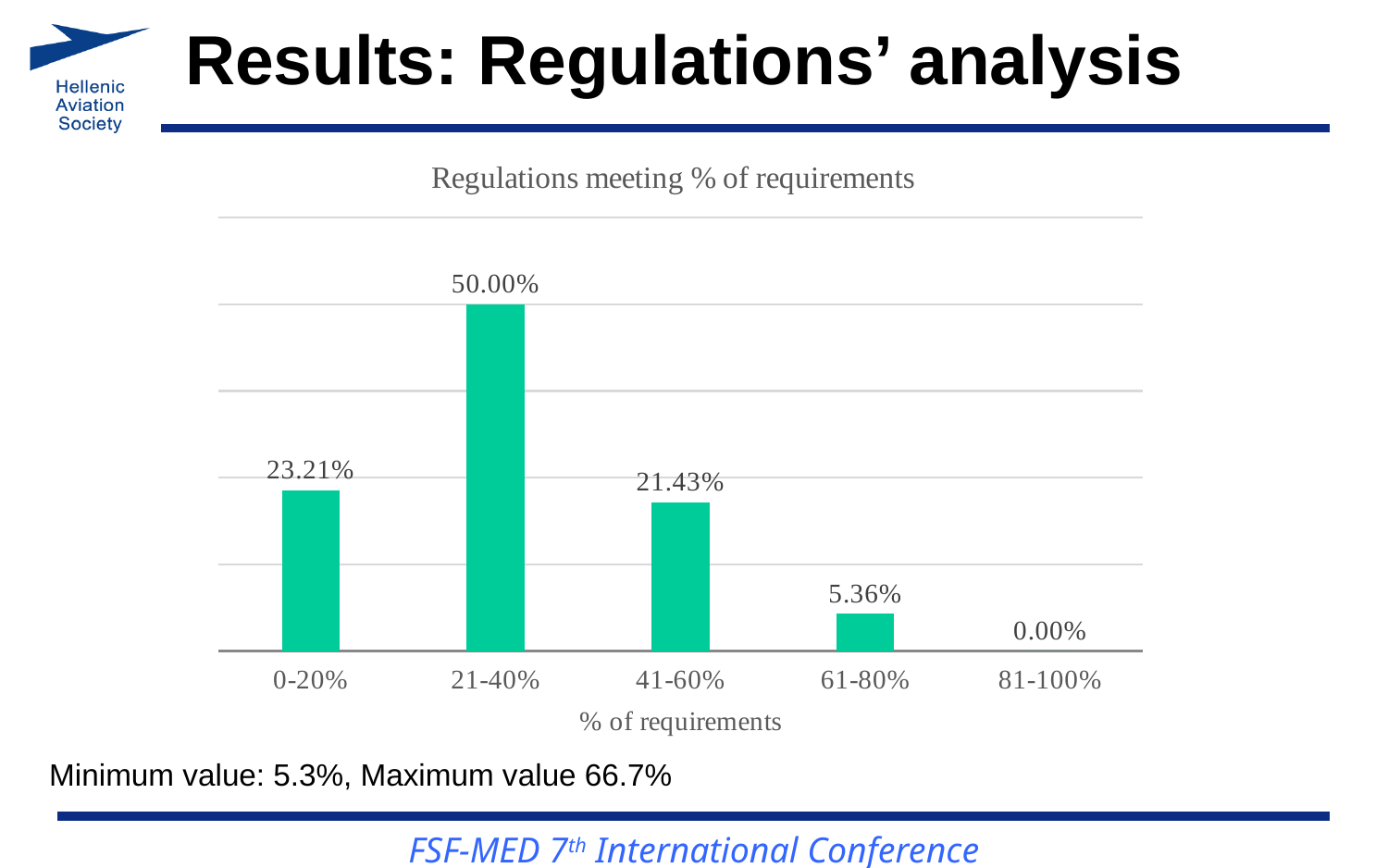
What is the title of the chart? Regulations meeting % of requirements What is the value for the 61-80% category? 5.36% What is the difference between the values for 21-40% and 41-60%? 28.57% What kind of chart is shown on the slide? Bar chart What is the value for the 0-20% category? 23.21% Which category has the highest value? 21-40% How many categories are shown on the x axis? 5 What is the value for the 21-40% category? 50.00% Which category has the lowest value? 81-100% What is the x-axis label of the chart? % of requirements What is the value for the 81-100% category? 0.00% Which is larger, the value for 0-20% or the value for 41-60%? 0-20%